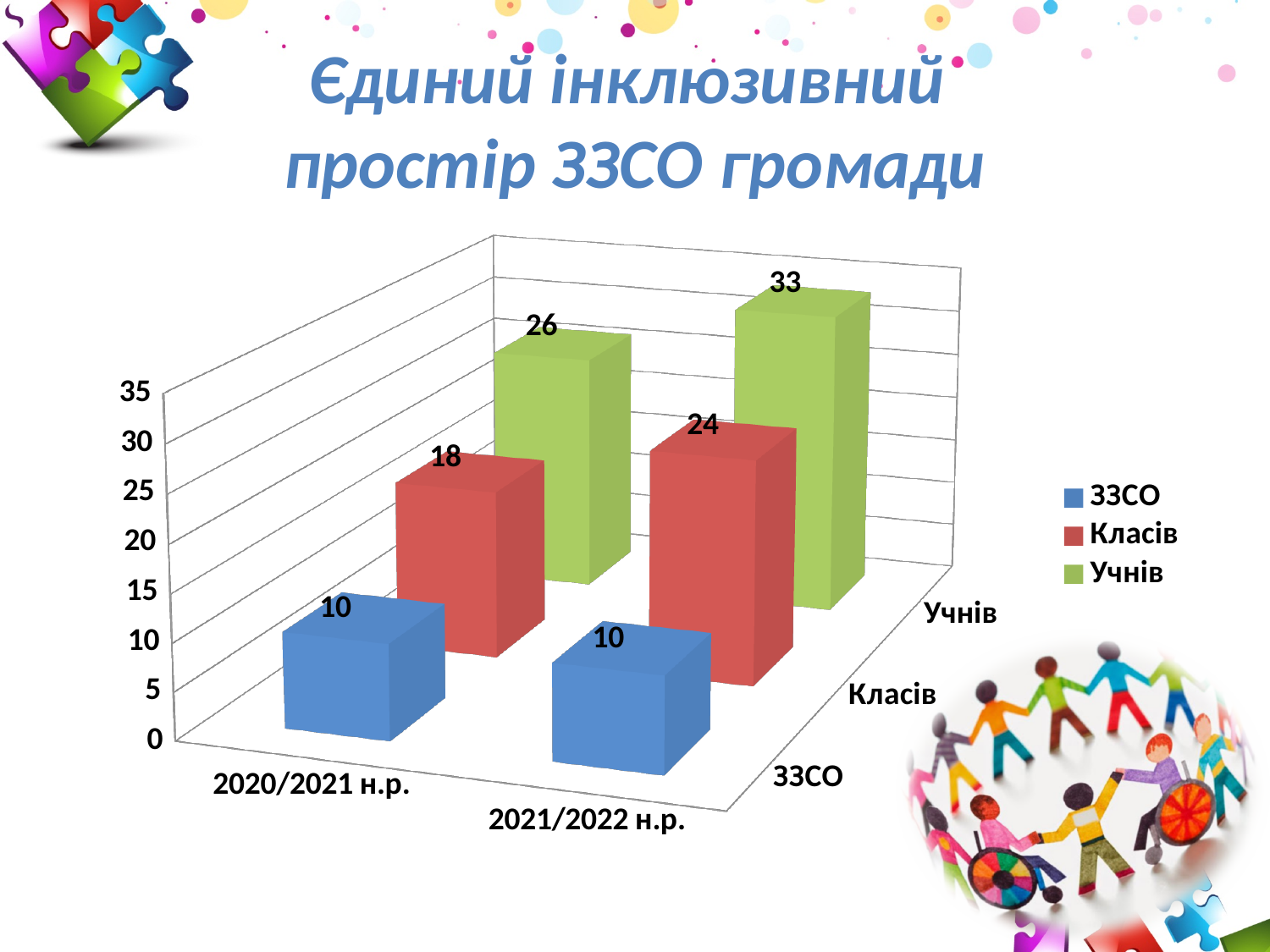
What is the value for Учнів in 2021/2022 н.р.? 33 Which series has the highest value in 2021/2022 н.р.? Учнів What is the value for Класів in 2020/2021 н.р.? 18 How many series does the legend list? 3 What is the value for Учнів in 2020/2021 н.р.? 26 What colour represents the Класів series? red Which is larger: Учнів in 2020/2021 н.р. or Учнів in 2021/2022 н.р.? Учнів in 2021/2022 н.р. Which series has the lowest value in 2020/2021 н.р.? ЗЗСО How many year categories are shown on the x axis? 2 What is the difference between the Класів values for 2021/2022 н.р. and 2020/2021 н.р.? 6 What type of chart is shown on the slide? bar chart What is the value for ЗЗСО in 2021/2022 н.р.? 10